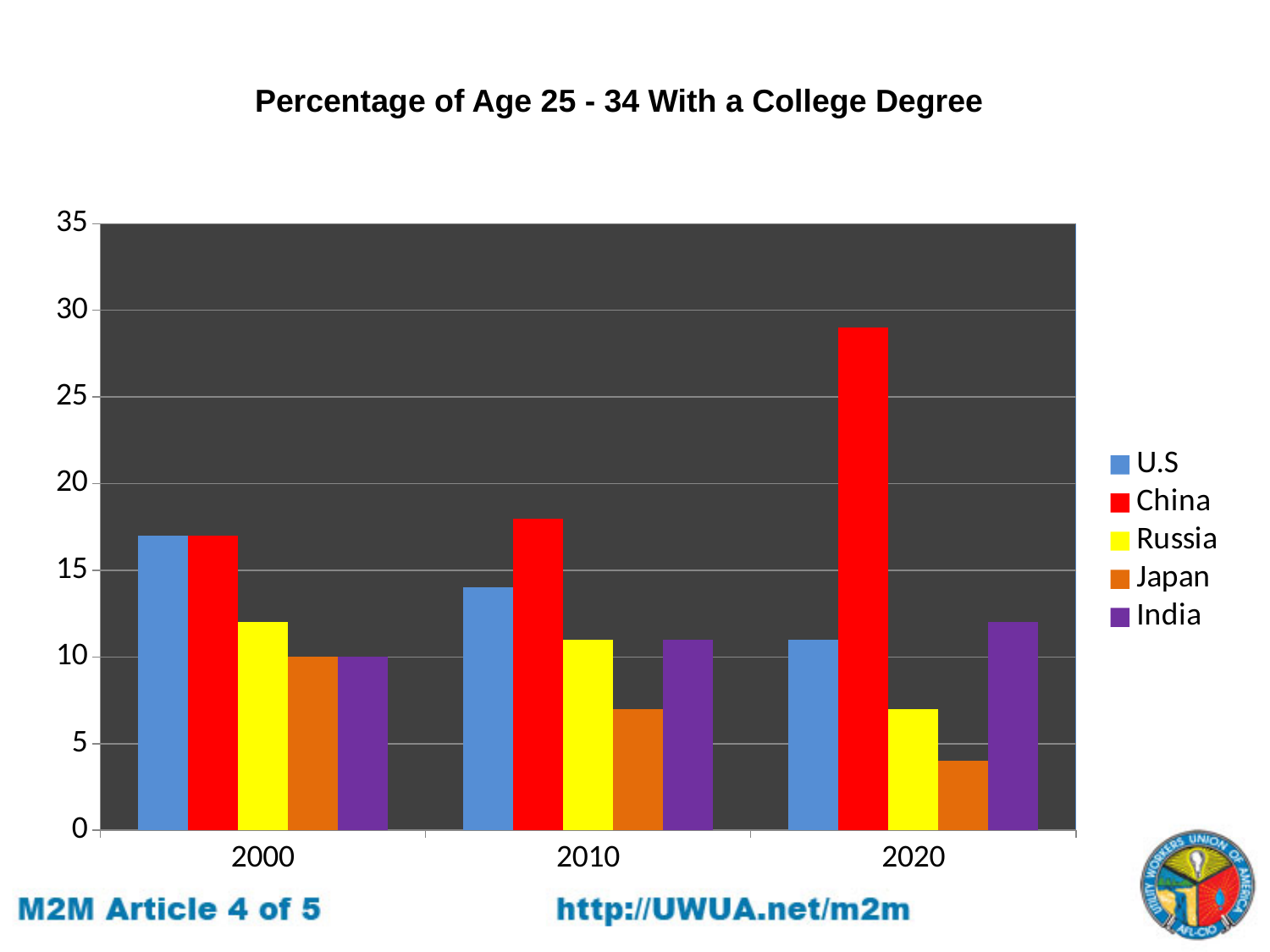
Does the value for China rise or fall from 2000 to 2020? rise What is the title of the chart? Percentage of Age 25 - 34 With a College Degree How many year categories are shown on the x axis? 3 Which country has the lowest value in 2020? Japan Is the value for U.S in 2000 greater or less than 15? greater Which country has the highest value in 2020? China Which is larger in 2020, the value for China or the value for U.S? China Is the value for Russia in 2020 greater or less than 10? less What kind of chart is shown on the slide? bar chart Is the value for China in 2020 greater or less than 25? greater How many series does the legend list? 5